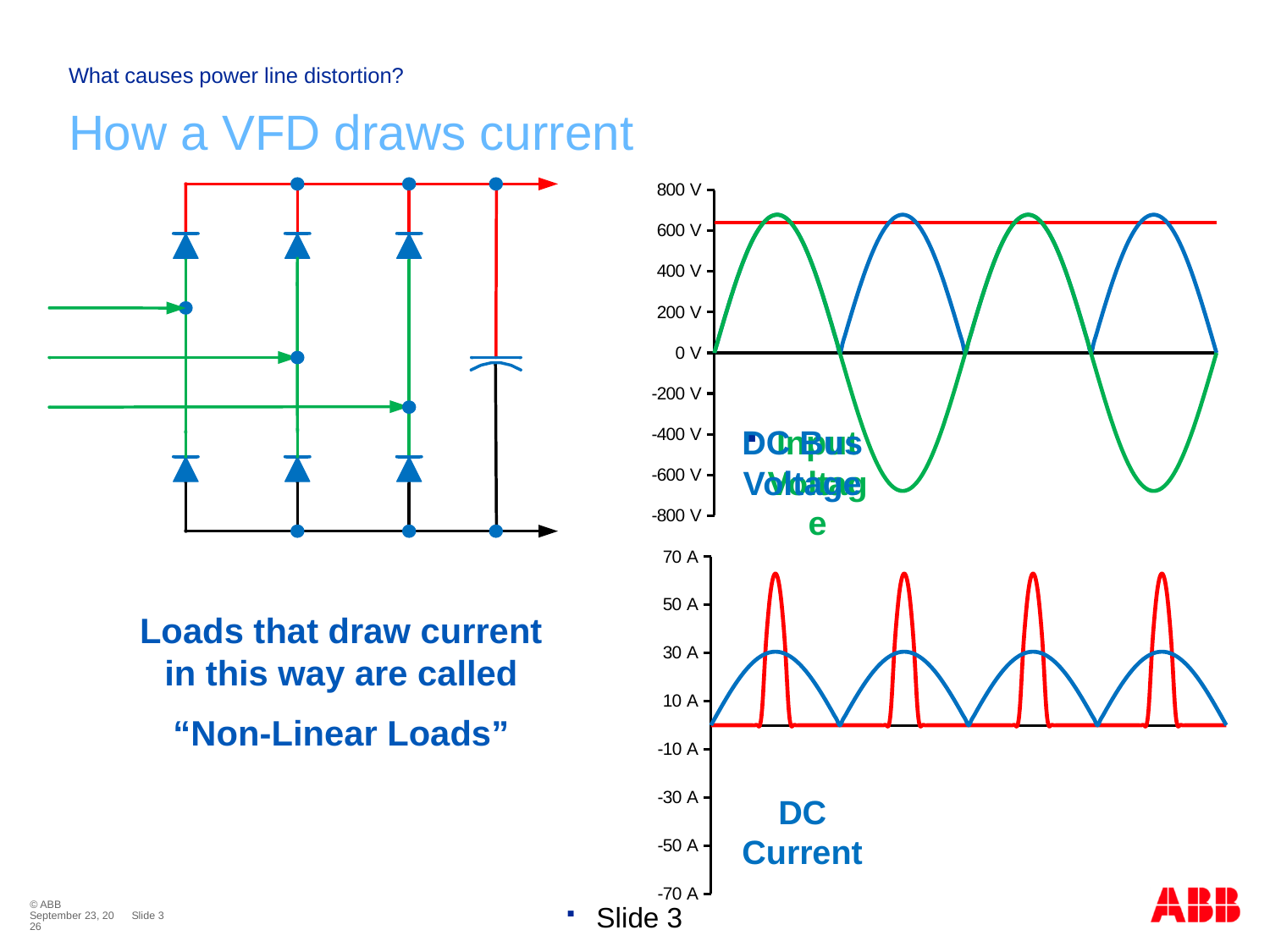
In the bottom current chart, is the peak of the red spikes greater or less than 50 A? greater In the bottom current chart, is the peak of the blue humps greater or less than 50 A? less In the bottom current chart, is the peak of the red spikes greater or less than 70 A? less In the bottom current chart, which reaches a higher peak value, the red spikes or the blue humps? the red spikes What kind of chart is the bottom chart on the right (the current chart)? line chart How many red spikes are plotted in the bottom current chart? 4 What is the highest value shown on the vertical axis of the bottom current chart? 70 A What kind of chart is the top chart on the right (the voltage chart)? line chart